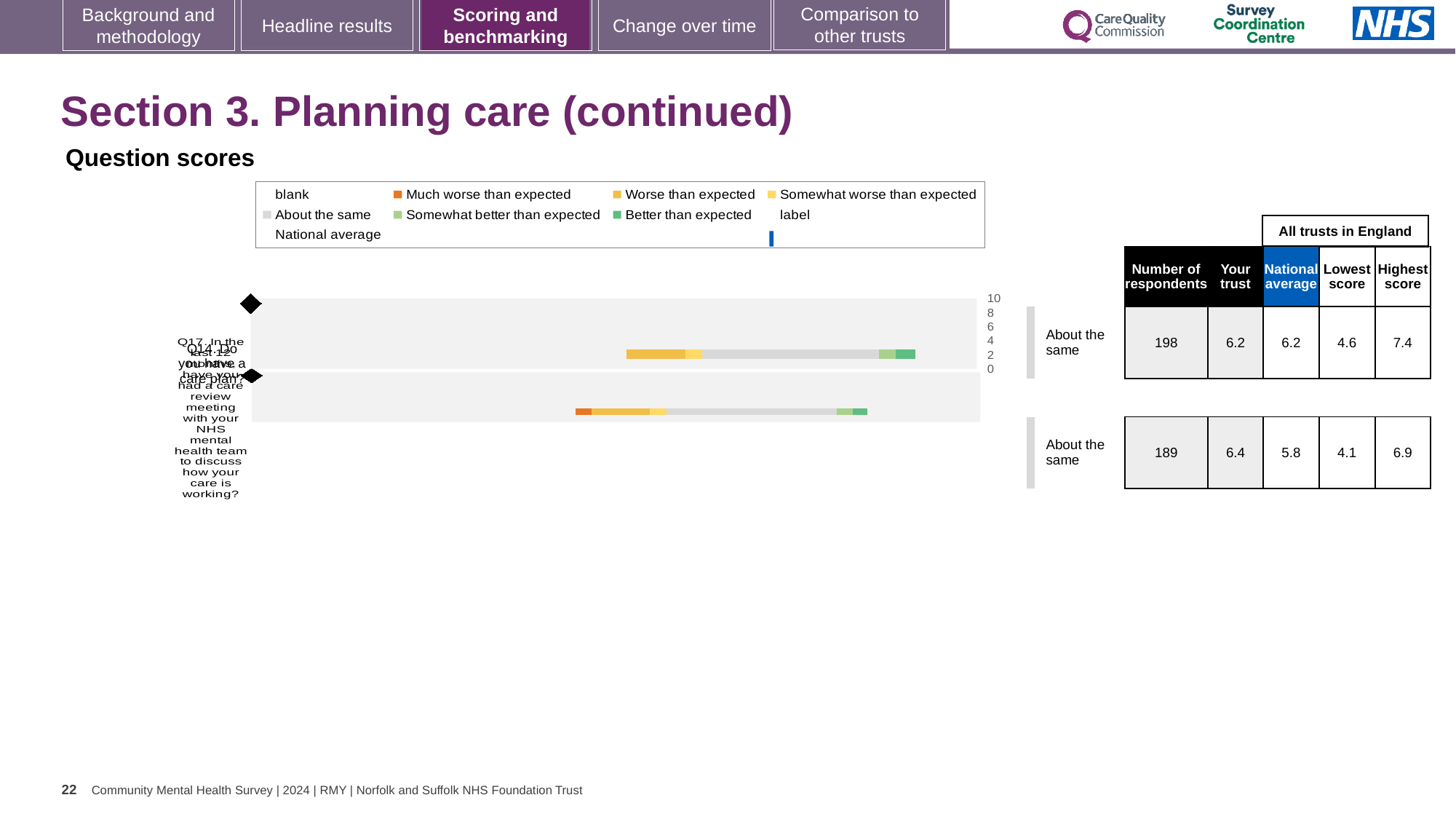
What is the national average score for Q17 (care review meeting in the last 12 months)? 5.8 Which question has more respondents, Q14 or Q17? Q14 How many survey questions are plotted in the Question scores chart? 2 How is the trust's result for Q14 categorised relative to expectations? About the same What is the lowest score among all trusts in England for Q14? 4.6 What is the number of respondents for Q14 (Do you have a care plan?)? 198 What is the 'Your trust' score for Q14 (Do you have a care plan?)? 6.2 What is the highest score among all trusts in England for Q17? 6.9 What is the difference between the trust score and the national average for Q17? 0.6 Which question has the higher 'Your trust' score, Q14 or Q17? Q17 What is the highest value shown on the chart's score axis? 10 What kind of chart is shown under 'Question scores'? bar chart